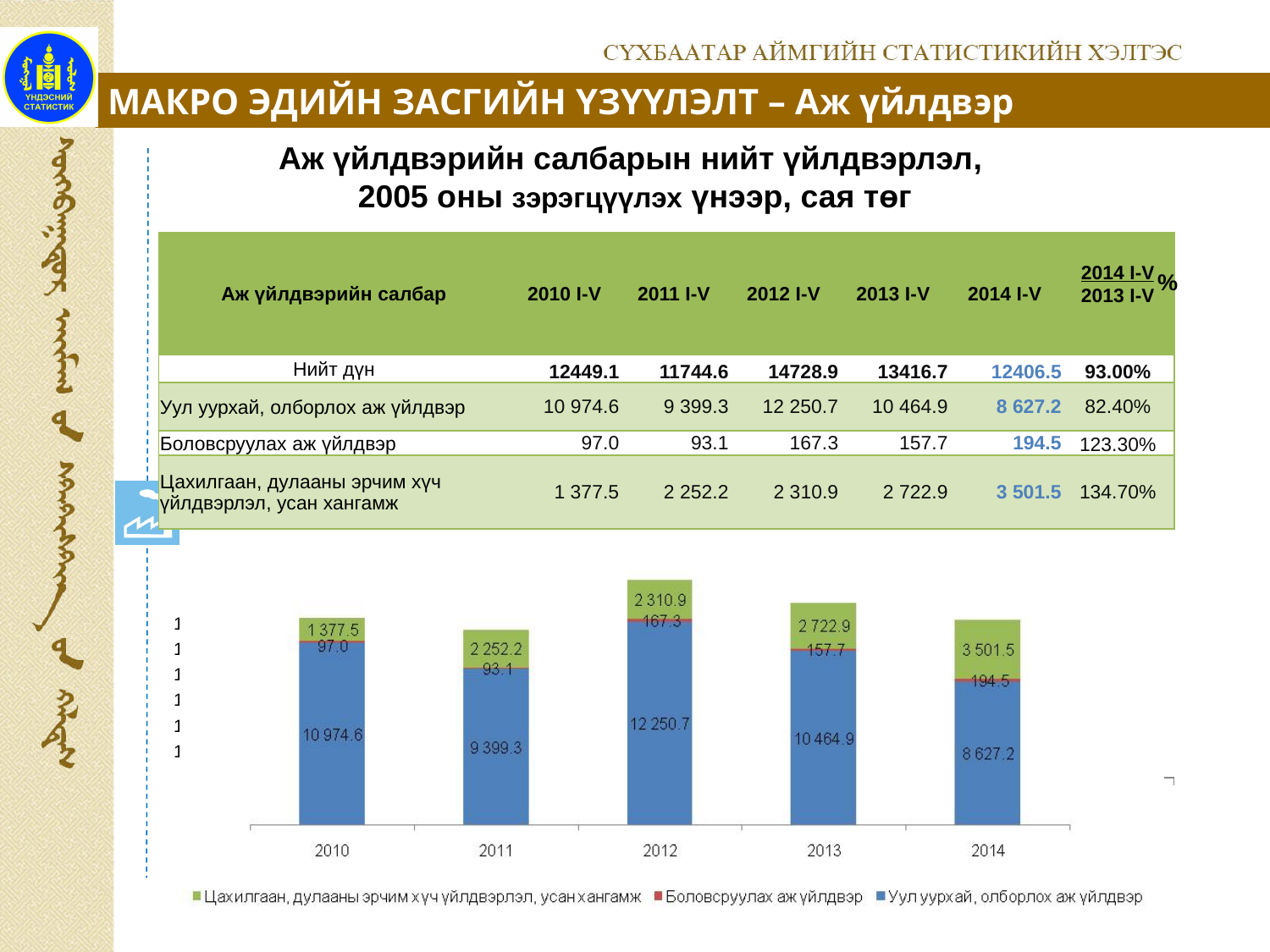
How many years are shown on the x axis of the chart? 5 Does the Цахилгаан, дулааны эрчим хүч үйлдвэрлэл, усан хангамж value rise or fall from 2010 to 2014 on the chart? rise What is the total of the stacked bar for 2010 on the chart? 12 449.1 What kind of chart is shown on the slide? stacked bar chart How many series does the chart legend list? 3 In which year is the Цахилгаан, дулааны эрчим хүч үйлдвэрлэл, усан хангамж value the highest on the chart? 2014 In which year is the Уул уурхай, олборлох аж үйлдвэр value the lowest on the chart? 2014 Which is larger on the chart: the Боловсруулах аж үйлдвэр value in 2012 or in 2013? 2012 What is the difference between the Уул уурхай, олборлох аж үйлдвэр values for 2012 and 2013 on the chart? 1 785.8 What is the value for Боловсруулах аж үйлдвэр in 2011 on the chart? 93.1 What is the value for Уул уурхай, олборлох аж үйлдвэр in 2012 on the chart? 12 250.7 What is the value for Цахилгаан, дулааны эрчим хүч үйлдвэрлэл, усан хангамж in 2014 on the chart? 3 501.5